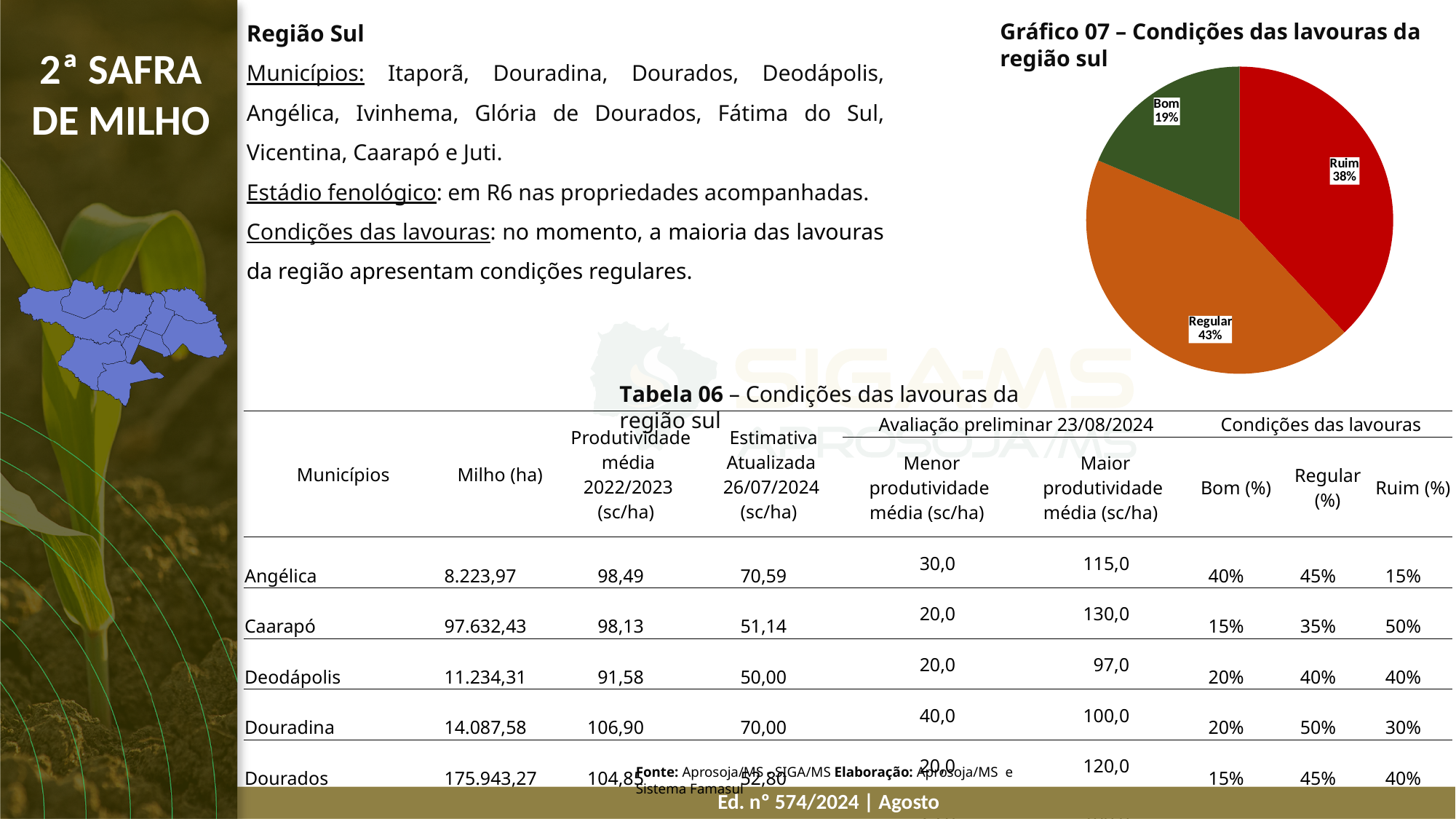
In Gráfico 07, what share of the lavouras is in the 'Regular' condition? 43% In Gráfico 07, what share of the lavouras is in the 'Ruim' condition? 38% In Gráfico 07, which condition category has the largest share? Regular In Gráfico 07, which condition category has the smallest share? Bom How many slices does the pie in Gráfico 07 have? 3 In Gráfico 07, what share of the lavouras is in the 'Bom' condition? 19% In Gráfico 07, what colour is the 'Bom' slice? Dark green In Gráfico 07, what is the difference in percentage points between the 'Ruim' and 'Bom' shares? 19 percentage points What type of chart is Gráfico 07? Pie chart In Gráfico 07, what is the difference in percentage points between the 'Regular' and 'Ruim' shares? 5 percentage points In Gráfico 07, which is larger: the 'Bom' share or the 'Ruim' share? Ruim What is the title of the pie chart on the slide? Gráfico 07 – Condições das lavouras da região sul